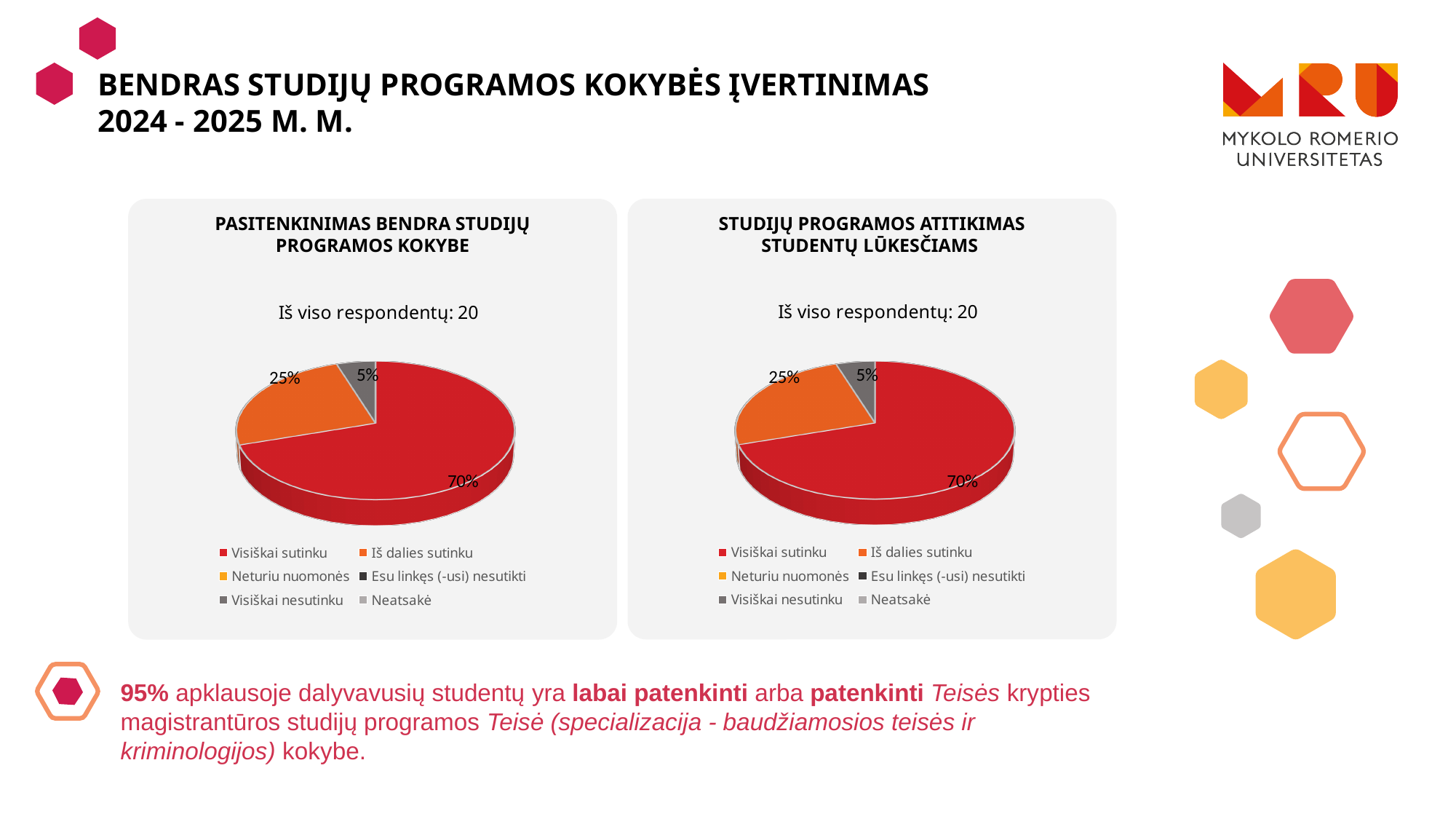
How many respondents in total does the right chart, 'Studijų programos atitikimas studentų lūkesčiams', report? 20 How many slices are shown in the right chart, 'Studijų programos atitikimas studentų lūkesčiams'? 3 In the left chart, 'Pasitenkinimas bendra studijų programos kokybe', what share of respondents answered 'Visiškai sutinku'? 70% In the left chart, 'Pasitenkinimas bendra studijų programos kokybe', what is the difference between the 'Visiškai sutinku' and 'Iš dalies sutinku' shares? 45% In the left chart, 'Pasitenkinimas bendra studijų programos kokybe', what is the percentage of the smallest slice? 5% How many entries does the legend of the left chart, 'Pasitenkinimas bendra studijų programos kokybe', list? 6 In the right chart, 'Studijų programos atitikimas studentų lūkesčiams', which answer has the largest slice? Visiškai sutinku In the left chart, 'Pasitenkinimas bendra studijų programos kokybe', what share of respondents answered 'Iš dalies sutinku'? 25% What kind of chart is used in the left chart, 'Pasitenkinimas bendra studijų programos kokybe'? Pie chart In the right chart, 'Studijų programos atitikimas studentų lūkesčiams', what share of respondents answered 'Iš dalies sutinku'? 25% In the right chart, 'Studijų programos atitikimas studentų lūkesčiams', which is larger: 'Iš dalies sutinku' or 'Visiškai sutinku'? Visiškai sutinku